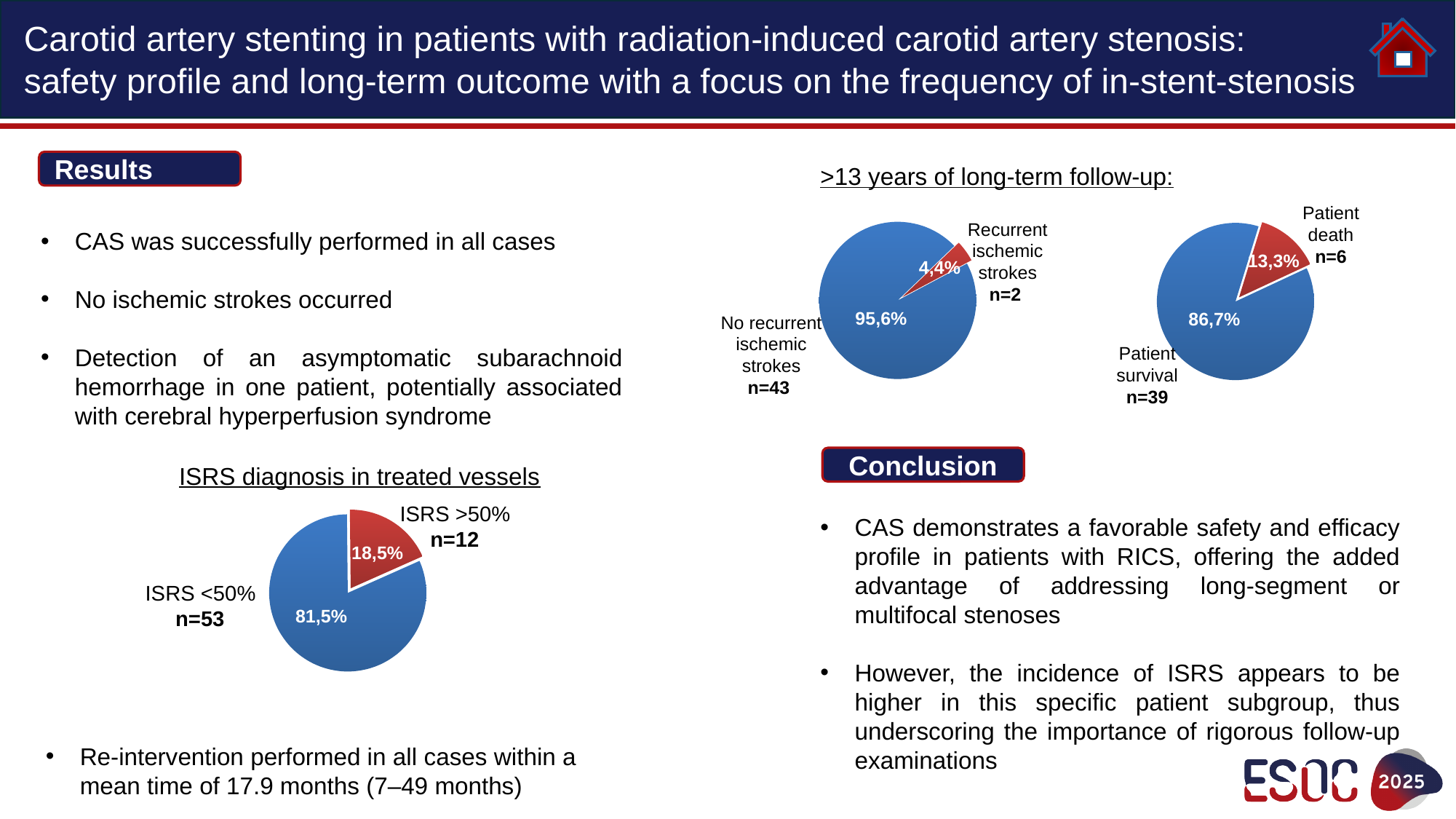
In the patient survival pie chart (top right), what percentage of patients died? 13,3% What kind of chart is the 'ISRS diagnosis in treated vessels' chart? Pie chart In the recurrent ischemic strokes pie chart (top middle), how many patients had recurrent ischemic strokes? n=2 In the recurrent ischemic strokes pie chart (top middle), what is the difference in percentage points between the 'No recurrent ischemic strokes' and 'Recurrent ischemic strokes' slices? 91,2 In the 'ISRS diagnosis in treated vessels' chart, what percentage of vessels had ISRS >50%? 18,5% How many slices does the patient survival pie chart (top right) have? 2 In the recurrent ischemic strokes pie chart (top middle), what percentage of patients had no recurrent ischemic strokes? 95,6% In the 'ISRS diagnosis in treated vessels' chart, which slice is larger, ISRS <50% or ISRS >50%? ISRS <50% In the patient survival pie chart (top right), how many patients survived? n=39 In the 'ISRS diagnosis in treated vessels' chart, how many vessels are in the ISRS >50% group? n=12 In the 'ISRS diagnosis in treated vessels' chart, what percentage of vessels had ISRS <50%? 81,5% In the patient survival pie chart (top right), which slice is the largest? Patient survival